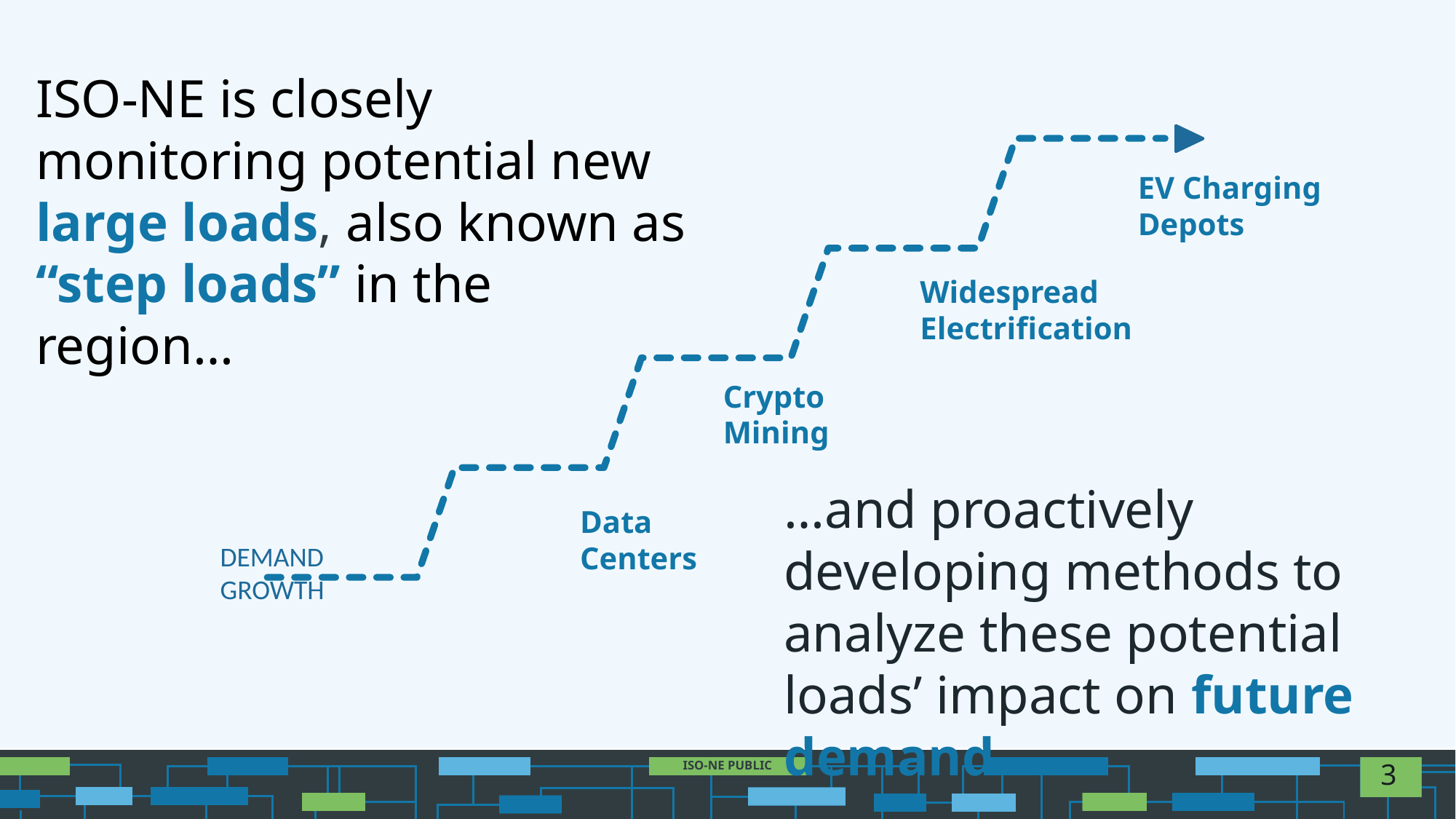
Which is positioned higher on the dashed step line, Crypto Mining or Widespread Electrification? Widespread Electrification What label appears at the starting point of the dashed step line? DEMAND GROWTH Which step load is labeled immediately after Data Centers along the dashed line? Crypto Mining Which labeled step load sits at the highest step of the dashed line? EV Charging Depots Which labeled step load sits at the lowest step of the dashed line? Data Centers What colour is the dashed step line in the diagram? blue How many named step loads are labeled along the dashed step line? 4 Which step load is labeled immediately before EV Charging Depots along the dashed line? Widespread Electrification Does the dashed step line rise or fall from left to right? rise